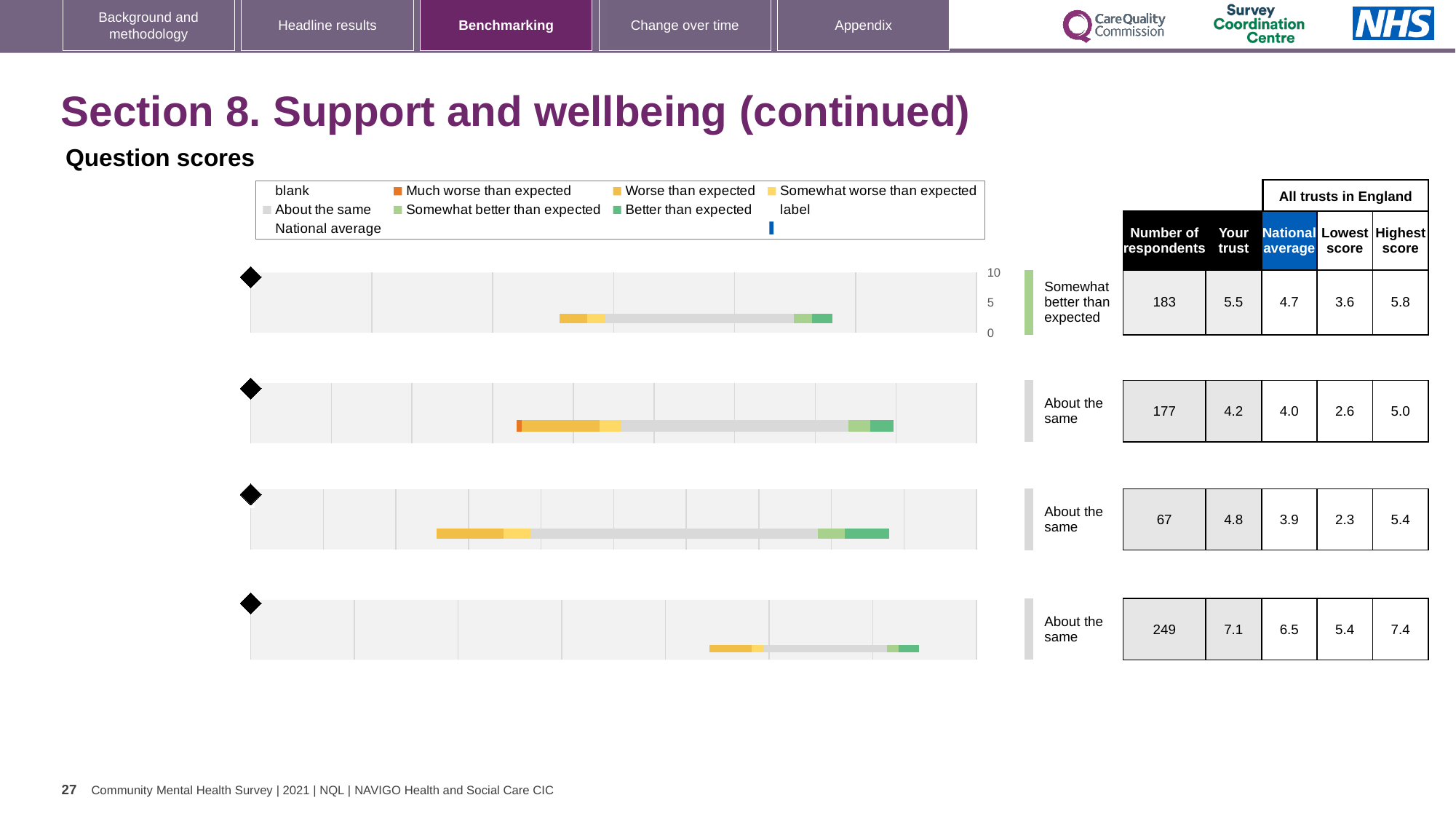
For the third chart from the top, what is the highest score among all trusts in England? 5.4 What benchmark category is given for the top chart? Somewhat better than expected For the second chart from the top, what is the national average score? 4.0 How many benchmarking bar charts are shown on the slide? 4 For the top chart, what is the 'Your trust' score shown in the table? 5.5 For the third chart from the top, how many respondents are listed? 67 What kind of chart is the top chart on the slide? bar chart Which legend entry is shown in orange? Much worse than expected What is the highest value shown on the axis of the top chart? 10 For the bottom chart, what is the difference between the 'Your trust' score and the national average? 0.6 For the top chart, which is larger: the 'Your trust' score or the national average? Your trust Which of the four charts has the highest 'Your trust' score? the fourth (bottom) chart